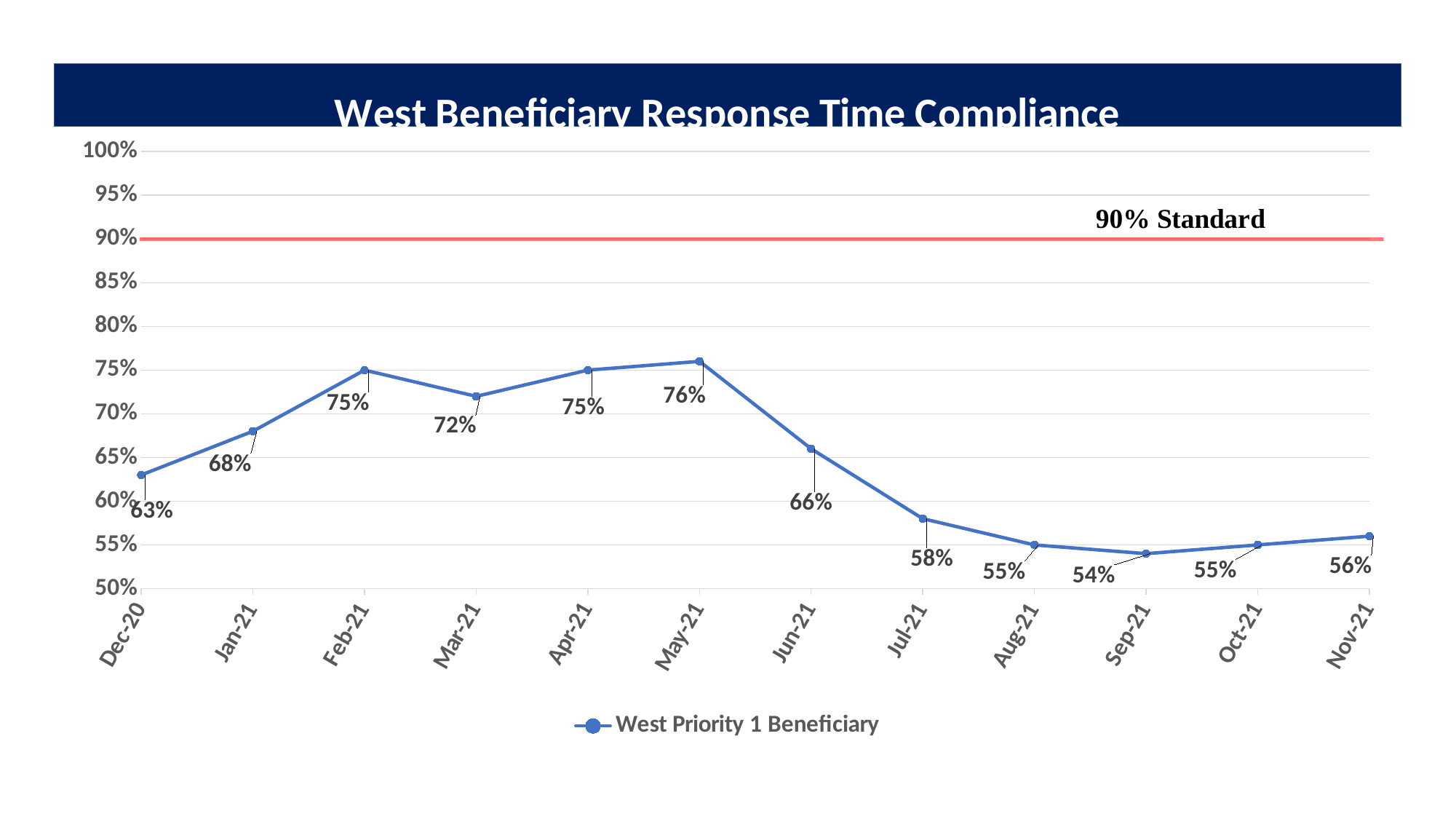
How many series does the legend list? 1 What standard level is marked by the red horizontal line? 90% Standard Is the value for Jul-21 greater or less than 60%? less Which month has the highest compliance value? May-21 Which month has the lowest compliance value? Sep-21 How many months are plotted on the x axis? 12 What is the compliance value for Dec-20? 63% What is the West Priority 1 Beneficiary compliance value for May-21? 76% Which is larger, the compliance value for Feb-21 or Jun-21? Feb-21 What kind of chart is shown on the slide? line chart What is the compliance value for Sep-21? 54% What is the difference between the compliance values for May-21 and Sep-21? 22%